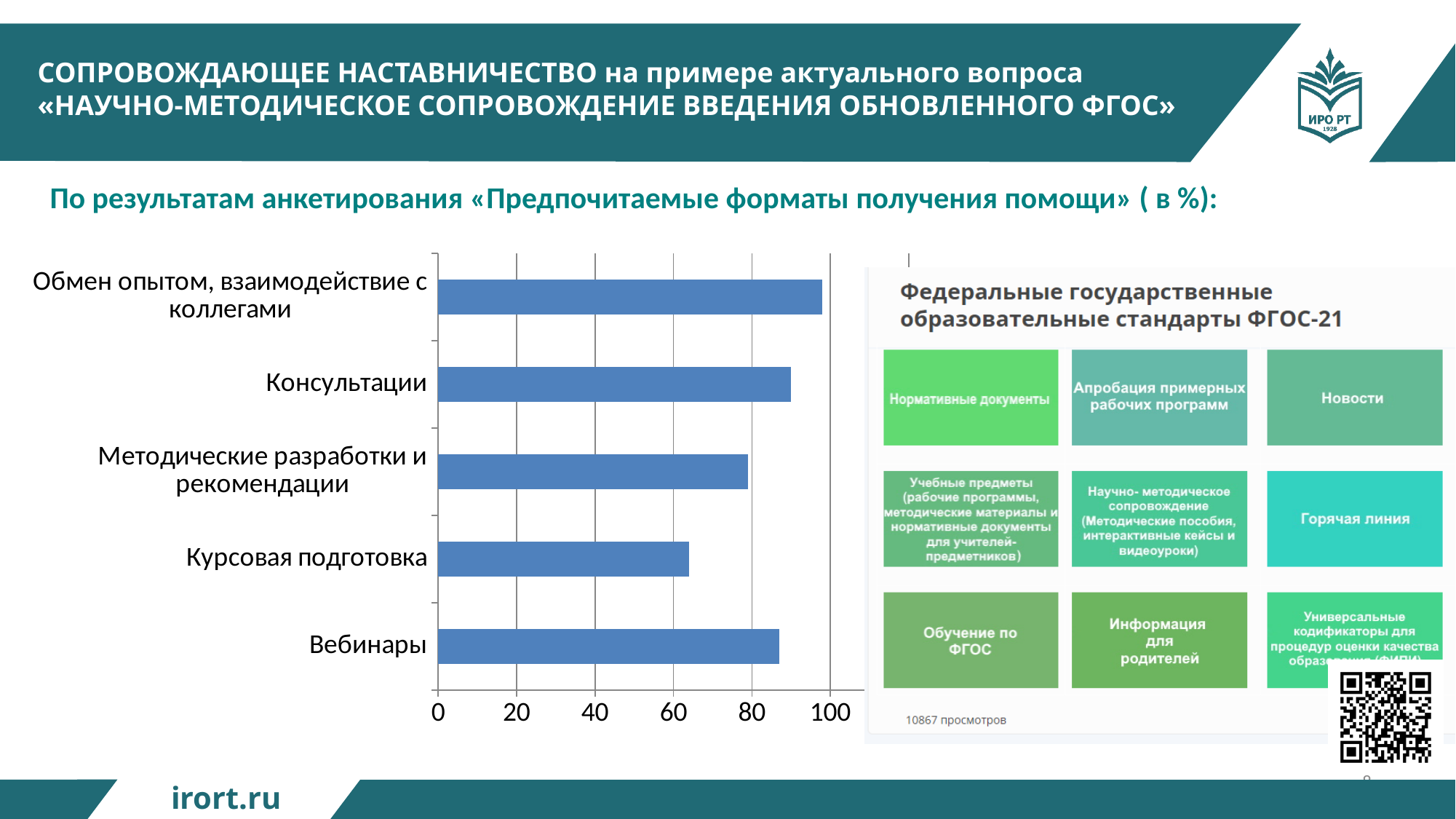
Is the value for Методические разработки и рекомендации greater or less than 60? greater What kind of chart is shown on the slide? bar chart Which is larger: the value for Методические разработки и рекомендации or the value for Курсовая подготовка? Методические разработки и рекомендации What is the maximum value shown on the horizontal axis of the bar chart? 100 Which is larger: the value for Обмен опытом, взаимодействие с коллегами or the value for Консультации? Обмен опытом, взаимодействие с коллегами Which category has the lowest value in the bar chart? Курсовая подготовка Is the value for Вебинары greater or less than 80? greater How many categories does the bar chart show? 5 Which category has the highest value in the bar chart? Обмен опытом, взаимодействие с коллегами Is the value for Обмен опытом, взаимодействие с коллегами greater or less than 80? greater